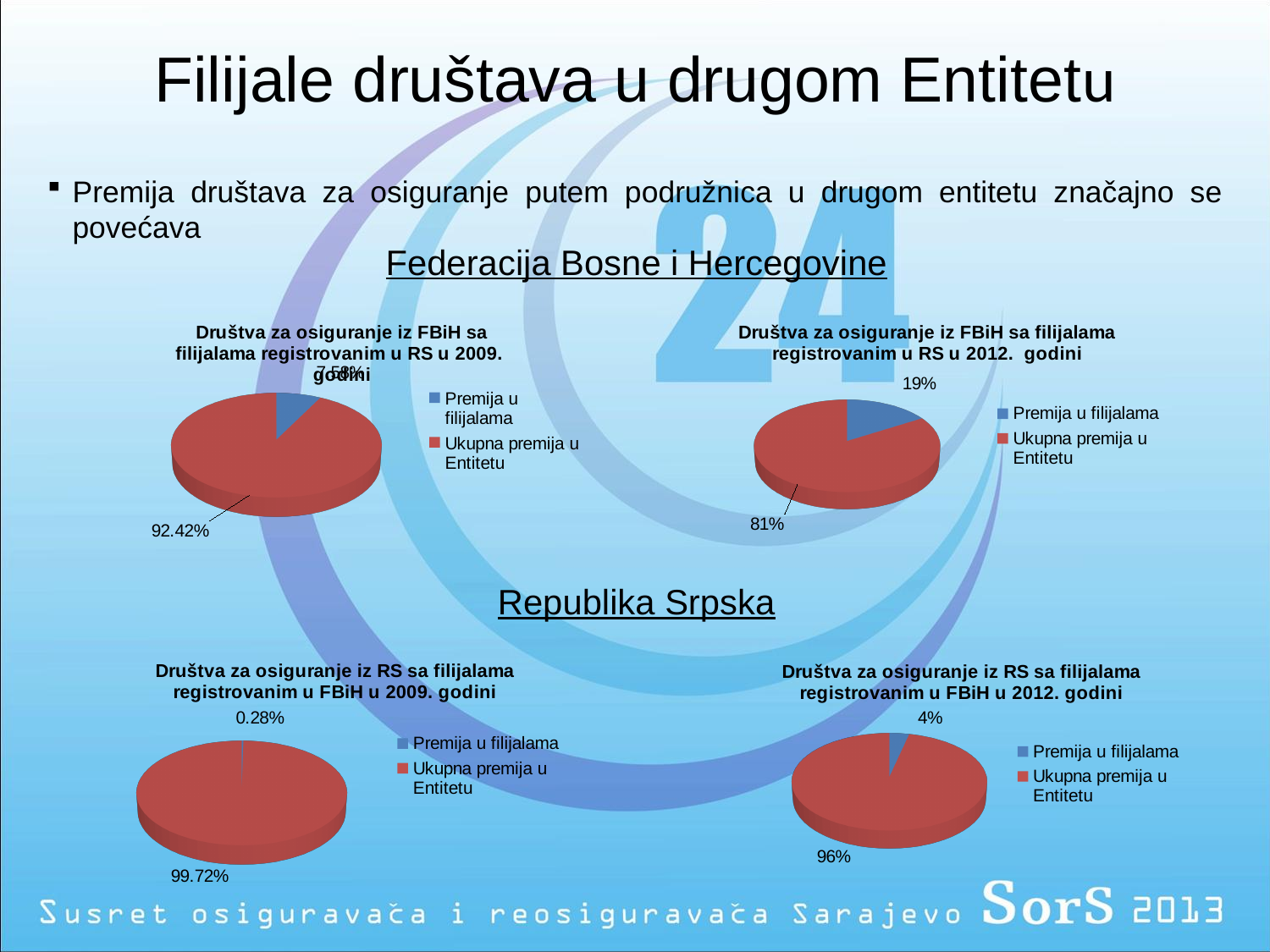
In the top-right chart (FBiH companies with branches in RS in 2012), what is the difference between the Ukupna premija u Entitetu share and the Premija u filijalama share? 62% In the bottom-right chart (RS companies with branches in FBiH in 2012), which slice is the smallest? Premija u filijalama In the bottom-left chart (RS companies with branches in FBiH in 2009), what share is labelled for Premija u filijalama? 0.28% In the top-left chart (FBiH companies with branches in RS in 2009), what share is labelled for Ukupna premija u Entitetu? 92.42% How many entries does the legend of the bottom-left chart (RS companies with branches in FBiH in 2009) list? 2 In the top-right chart (FBiH companies with branches in RS in 2012), what share is labelled for Ukupna premija u Entitetu? 81% In the top-right chart (FBiH companies with branches in RS in 2012), which slice is the largest? Ukupna premija u Entitetu In the top-right chart (FBiH companies with branches in RS in 2012), what share is labelled for Premija u filijalama? 19% In the bottom-right chart (RS companies with branches in FBiH in 2012), what share is labelled for Premija u filijalama? 4% What type of chart is used for the four charts on this slide? Pie chart In the bottom-left chart (RS companies with branches in FBiH in 2009), what share is labelled for Ukupna premija u Entitetu? 99.72% In the bottom-right chart (RS companies with branches in FBiH in 2012), what share is labelled for Ukupna premija u Entitetu? 96%